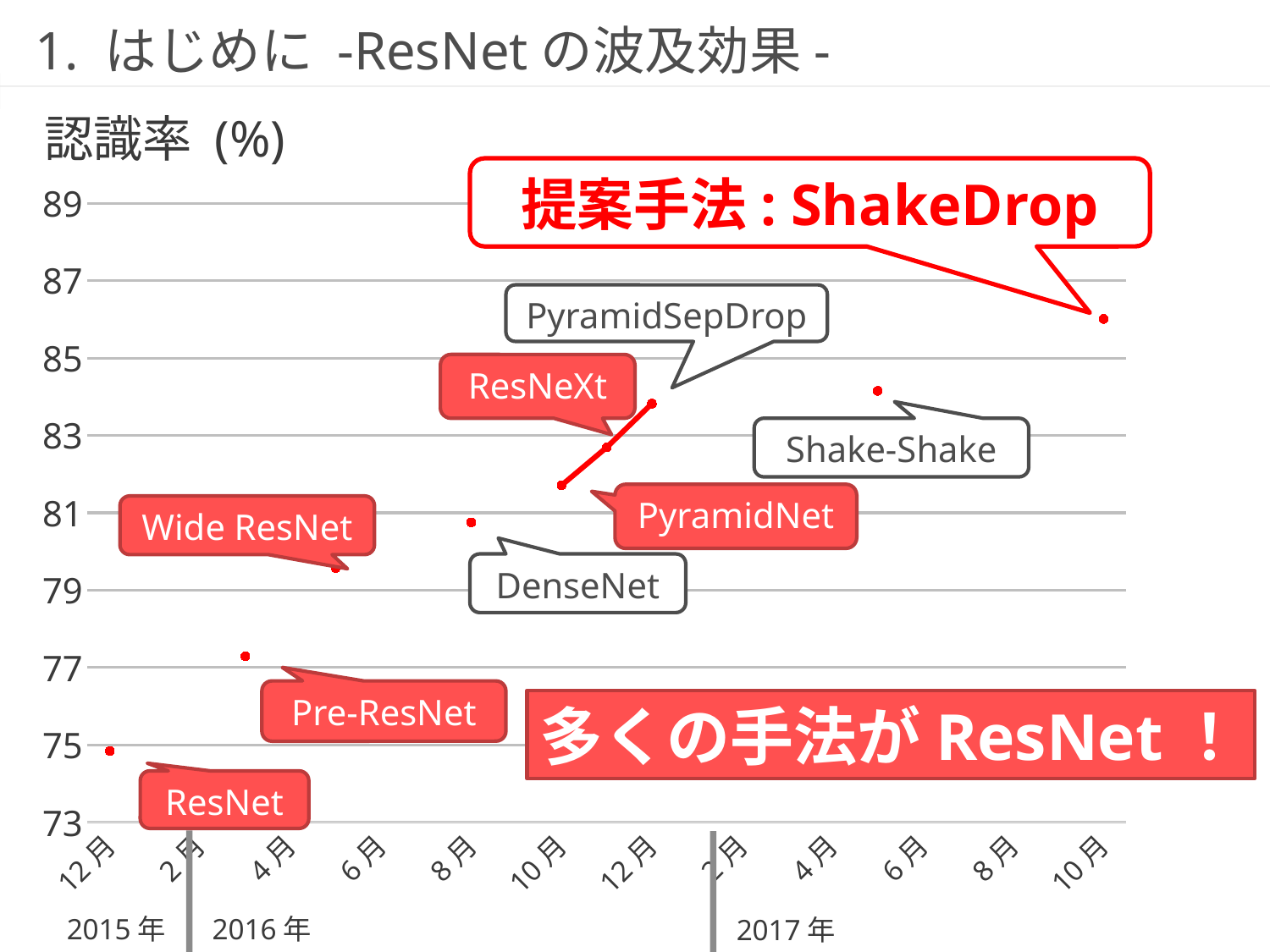
Which has a higher recognition rate, Wide ResNet or Pre-ResNet? Wide ResNet Do the recognition rates generally rise or fall over time along the x axis? rise Which has a higher recognition rate, ShakeDrop or Shake-Shake? ShakeDrop Is the recognition rate for Wide ResNet greater or less than 81? less Which method has the lowest recognition rate on the chart? ResNet Is the recognition rate for DenseNet greater or less than 79? greater What kind of chart is shown on the slide? scatter chart Which method has the highest recognition rate on the chart? ShakeDrop How many data points are plotted on the chart? 9 Is the recognition rate for ShakeDrop greater or less than 85? greater